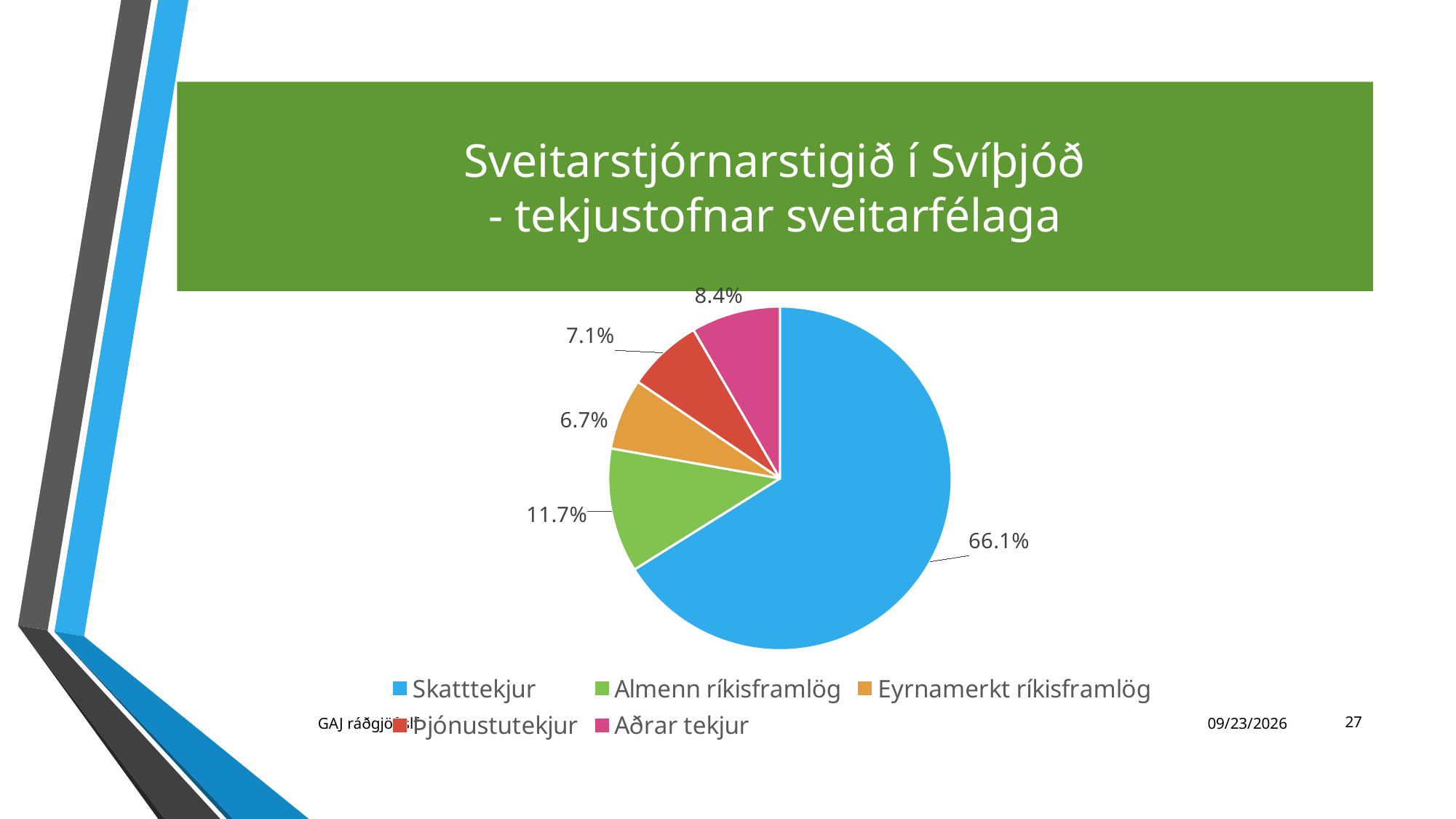
What percentage is shown for Almenn ríkisframlög? 11.7% What is the difference in percentage points between Skatttekjur and Almenn ríkisframlög? 54.4 Which category has the smallest slice of the pie? Eyrnamerkt ríkisframlög What is the value for Eyrnamerkt ríkisframlög? 6.7% What share of the pie does Skatttekjur represent? 66.1% Which category has the largest slice of the pie? Skatttekjur What type of chart is shown on the slide? Pie chart How many slices does the pie chart have? 5 What is the value for Þjónustutekjur? 7.1% Which is larger, Aðrar tekjur or Þjónustutekjur? Aðrar tekjur What colour is the slice for Skatttekjur? Blue What percentage is labelled for Aðrar tekjur? 8.4%